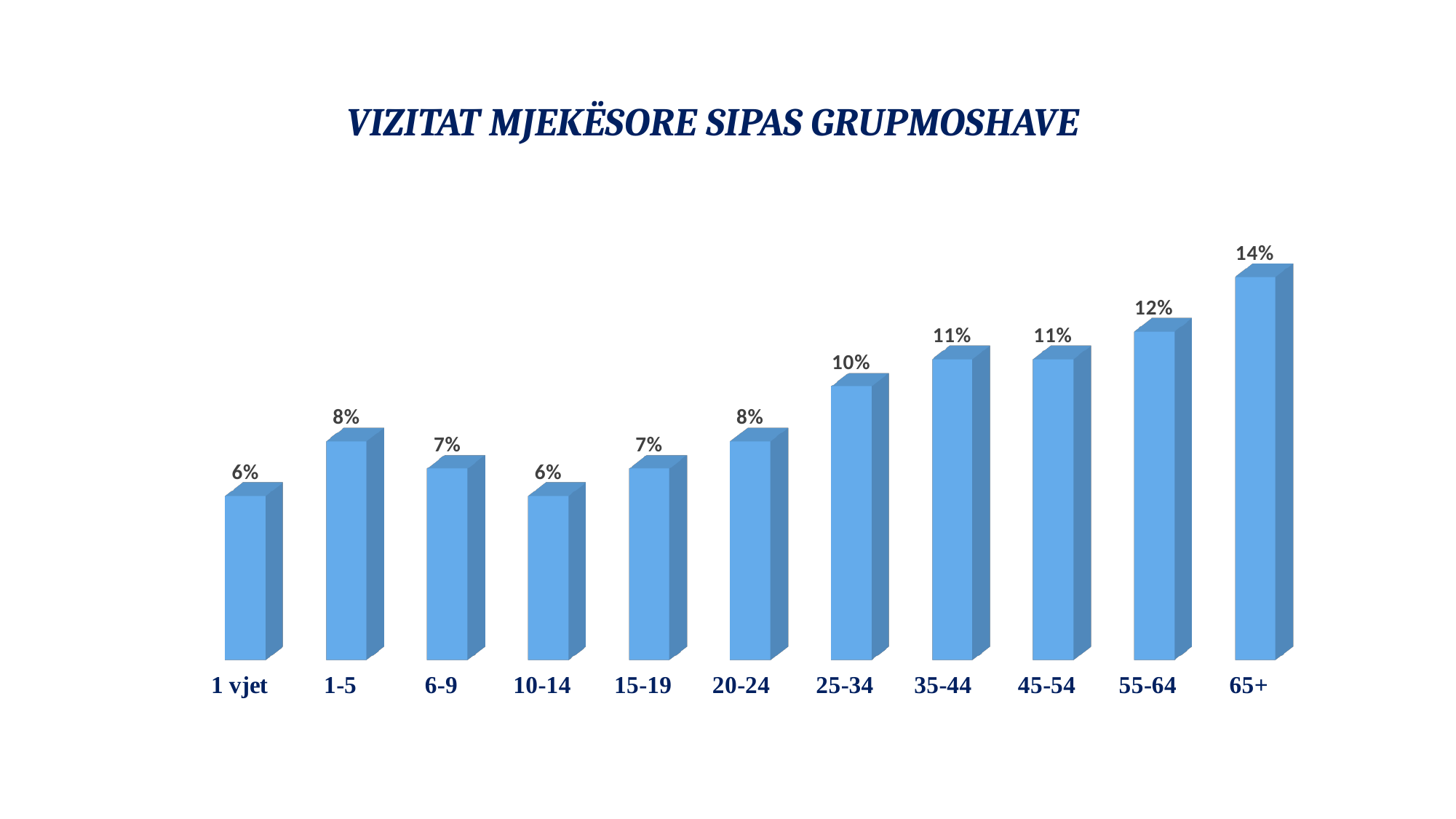
Which is larger, the value for 1-5 or the value for 10-14? 1-5 What is the value for the 65+ age group? 14% What is the difference between the values for 65+ and 1-5? 6% Which is larger, the value for 20-24 or the value for 35-44? 35-44 Which age group has the highest value? 65+ What kind of chart is shown on the slide? Bar chart What is the difference between the values for 55-64 and 25-34? 2% What is the title of the chart? VIZITAT MJEKËSORE SIPAS GRUPMOSHAVE What is the value for the 55-64 age group? 12% How many age group categories are shown in the chart? 11 What is the value for the 25-34 age group? 10% What is the value for the 1 vjet category? 6%